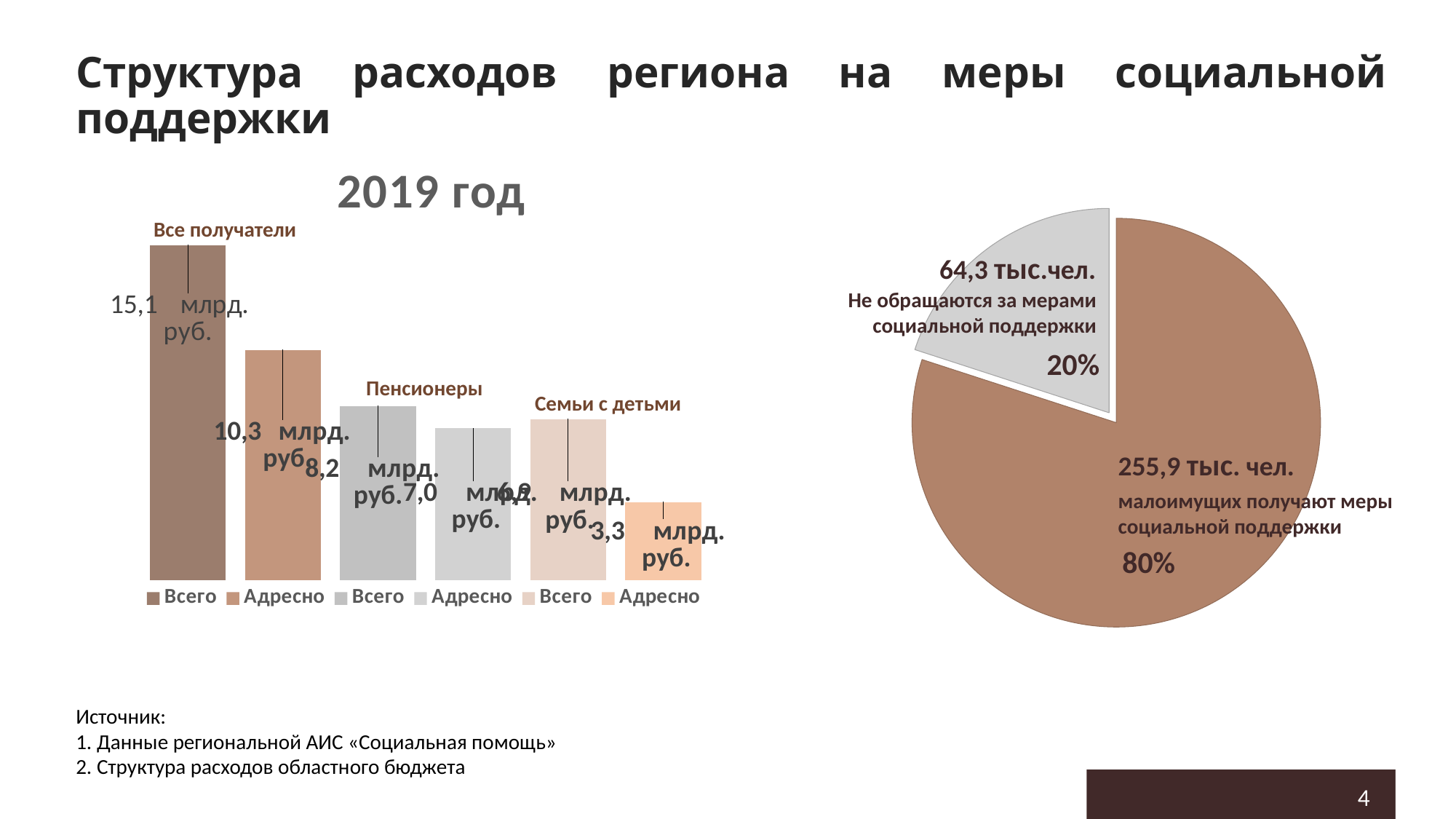
In the "2019 год" bar chart, what is the value of the "Всего" bar for "Все получатели"? 15,1 млрд. руб. In the pie chart on the right, what share of the pie corresponds to those who receive social support measures (малоимущих получают меры социальной поддержки)? 80% What kind of chart is the chart titled "2019 год" on the left of the slide? bar chart In the "2019 год" bar chart, what is the difference between the "Всего" and "Адресно" values for "Все получатели"? 4,8 млрд. руб. In the "2019 год" bar chart, what is the value of the "Адресно" bar for "Все получатели"? 10,3 млрд. руб. In the pie chart on the right, how many people do not apply for social support measures (Не обращаются за мерами социальной поддержки)? 64,3 тыс.чел. In the "2019 год" bar chart, which bar is the tallest? Всего for Все получатели In the "2019 год" bar chart, which bar is the shortest? Адресно for Семьи с детьми What kind of chart is shown on the right of the slide? pie chart In the "2019 год" bar chart, how many bars are plotted? 6 In the "2019 год" bar chart, what is the value of the "Всего" bar for "Пенсионеры"? 8,2 млрд. руб. In the "2019 год" bar chart, what is the value of the "Адресно" bar for "Семьи с детьми"? 3,3 млрд. руб.